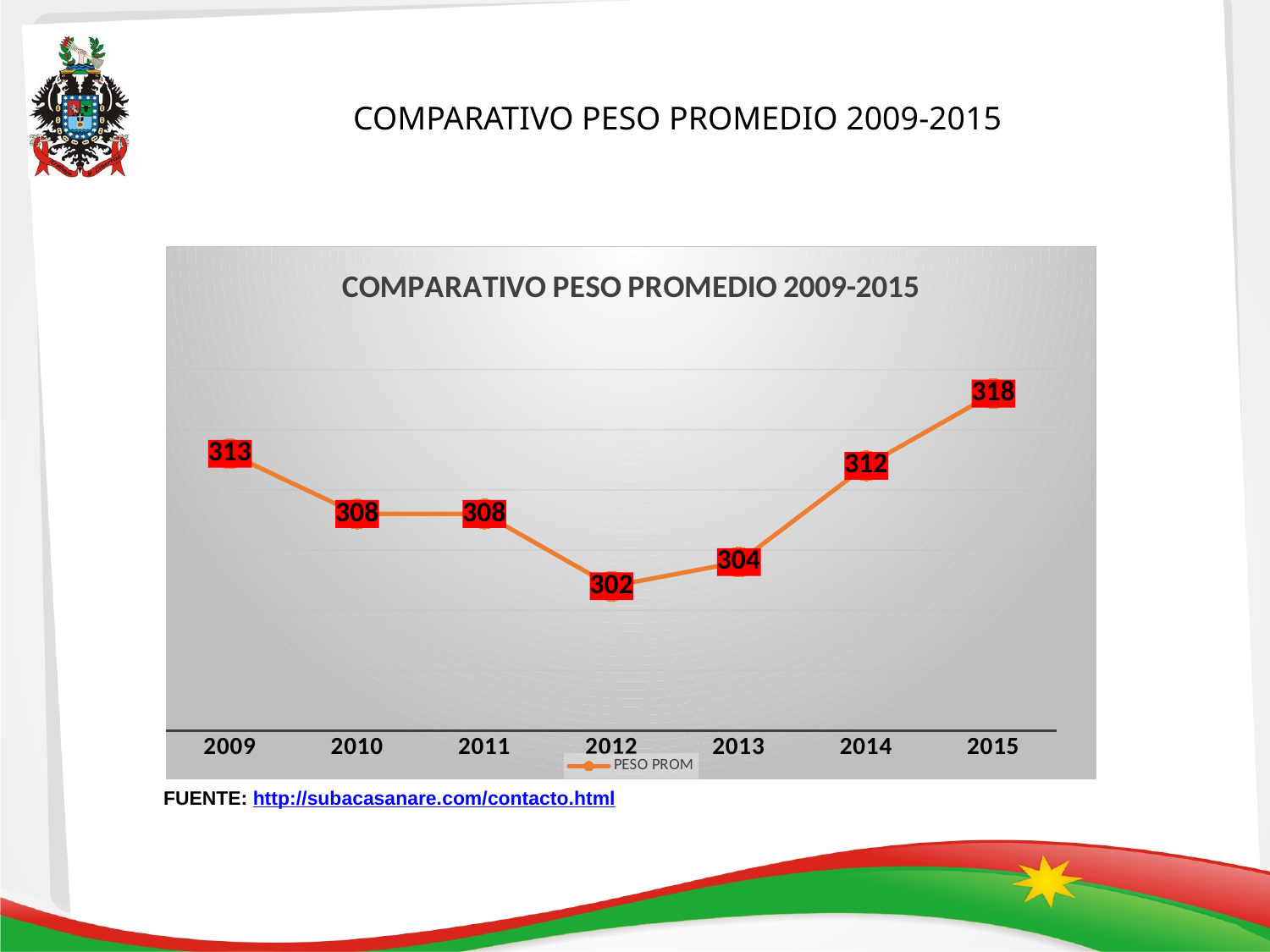
How many years are plotted on the x axis? 7 What is the difference between the PESO PROM values for 2009 and 2010? 5 How many series does the legend list? 1 Which year has the highest PESO PROM value? 2015 Which year has a larger PESO PROM value, 2013 or 2014? 2014 What is the difference between the PESO PROM values for 2015 and 2012? 16 What kind of chart is shown on the slide? Line chart Do the PESO PROM values rise or fall from 2012 to 2015? Rise What is the PESO PROM value for 2012? 302 What is the PESO PROM value for 2009? 313 What is the PESO PROM value for 2015? 318 Which year has the lowest PESO PROM value? 2012